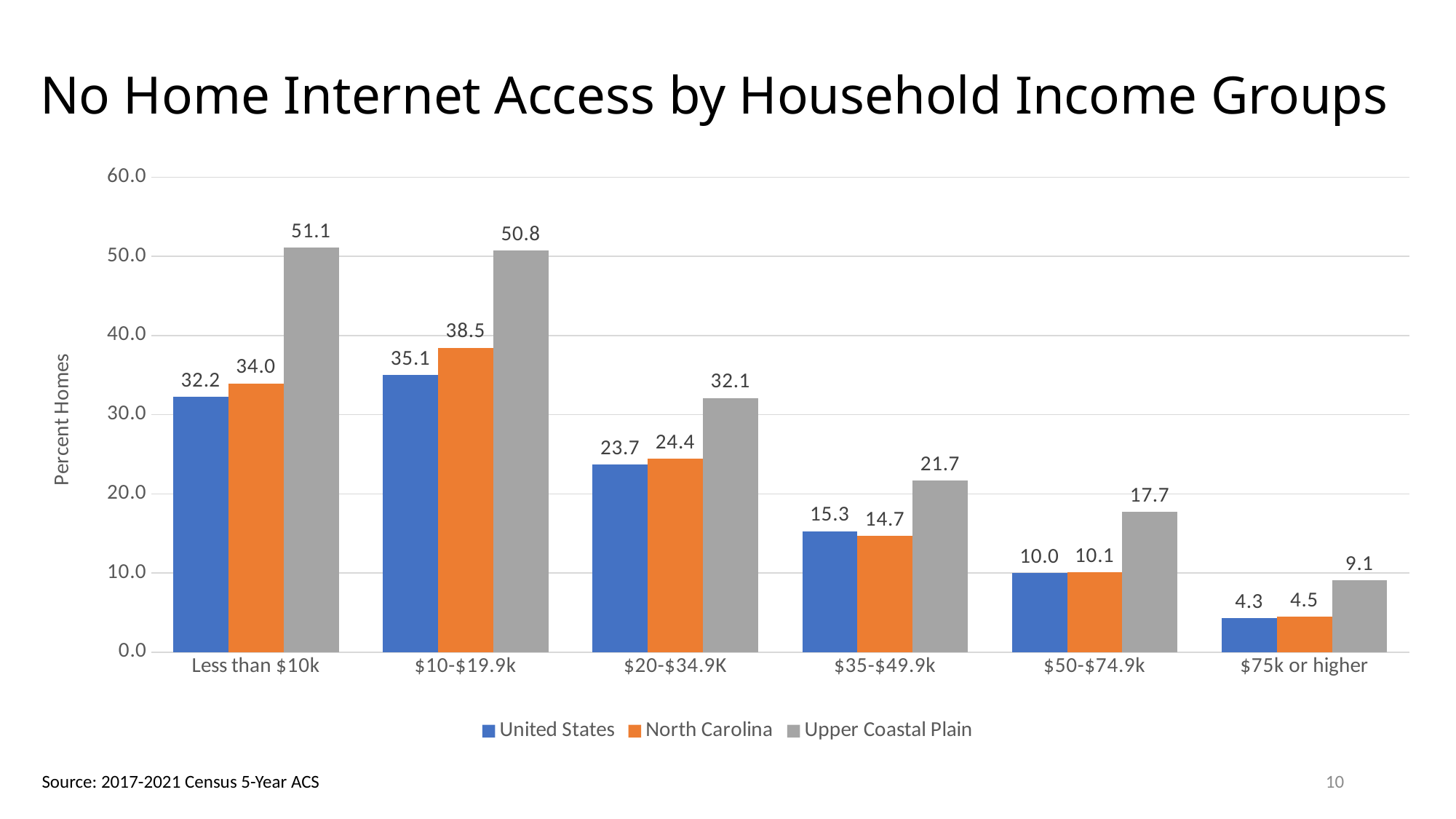
Do the Upper Coastal Plain values rise or fall as income groups increase along the x axis? Fall What is the difference between the Upper Coastal Plain and United States values in the $20-$34.9K income group? 8.4 What is the label of the y axis? Percent Homes What is the value for North Carolina in the $10-$19.9k income group? 38.5 What is the value for United States in the $75k or higher income group? 4.3 Which income group has the highest value for the Upper Coastal Plain series? Less than $10k Which income group has the lowest value for the North Carolina series? $75k or higher What is the value for Upper Coastal Plain in the Less than $10k income group? 51.1 What kind of chart is shown on the slide? Bar chart How many income groups are shown on the x axis? 6 How many series does the legend list? 3 In the $35-$49.9k income group, which is larger: the United States value or the Upper Coastal Plain value? Upper Coastal Plain